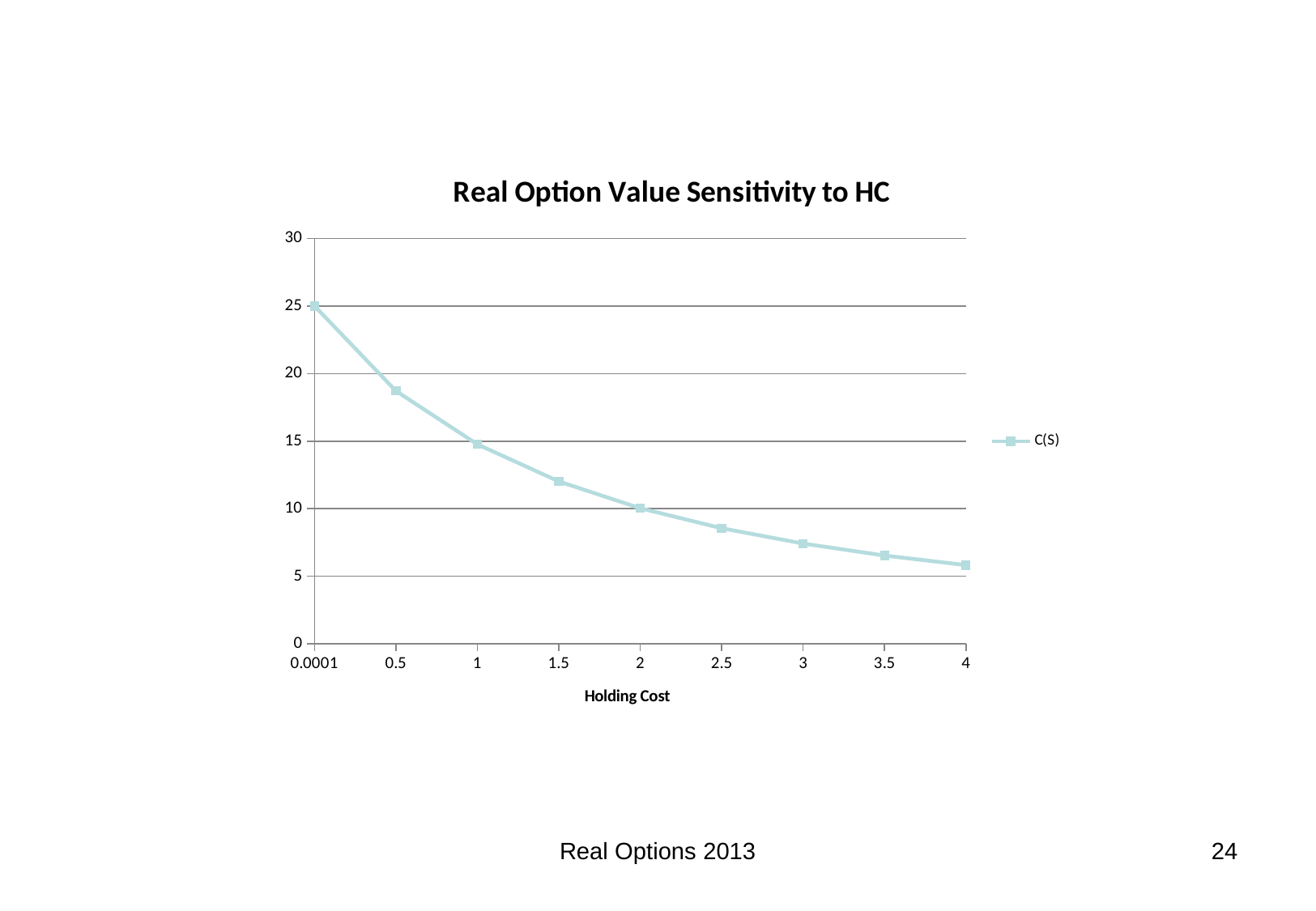
How many data points are plotted for C(S)? 9 Is the value of C(S) at a holding cost of 4 greater or less than 5? greater What type of chart is shown on the slide? line chart At which holding cost is C(S) highest? 0.0001 What is the label of the x axis? Holding Cost Does C(S) rise or fall as holding cost increases along the x axis? fall At which holding cost is C(S) lowest? 4 How many series does the legend list? 1 What is the title of the chart? Real Option Value Sensitivity to HC What is the value of C(S) at a holding cost of 2? 10 What is the value of C(S) at a holding cost of 0.0001? 25